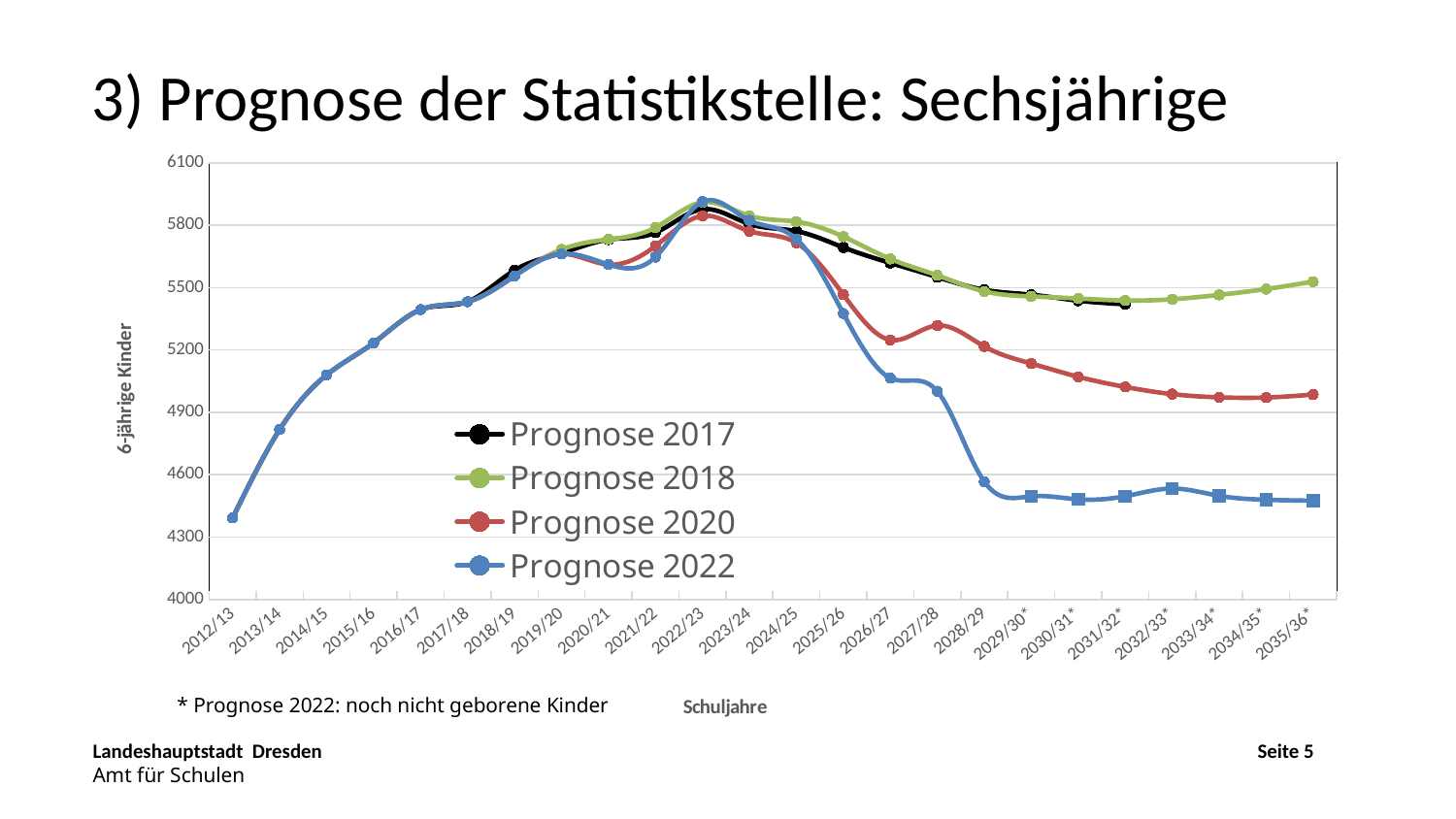
Is the value of Prognose 2022 for 2022/23 greater or less than 5800? greater What kind of chart is shown on the slide? line chart In 2035/36*, which series has the higher value, Prognose 2018 or Prognose 2020? Prognose 2018 Is the value of Prognose 2017 for 2031/32* greater or less than 5500? less Which series has the lowest value in 2035/36*? Prognose 2022 Does Prognose 2022 rise or fall between 2022/23 and 2028/29? fall Is the value of Prognose 2020 for 2035/36* greater or less than 5200? less In which school year does Prognose 2022 reach its highest value? 2022/23 How many series does the legend list? 4 How many school years are shown on the x axis? 24 What is the label of the y axis? 6-jährige Kinder